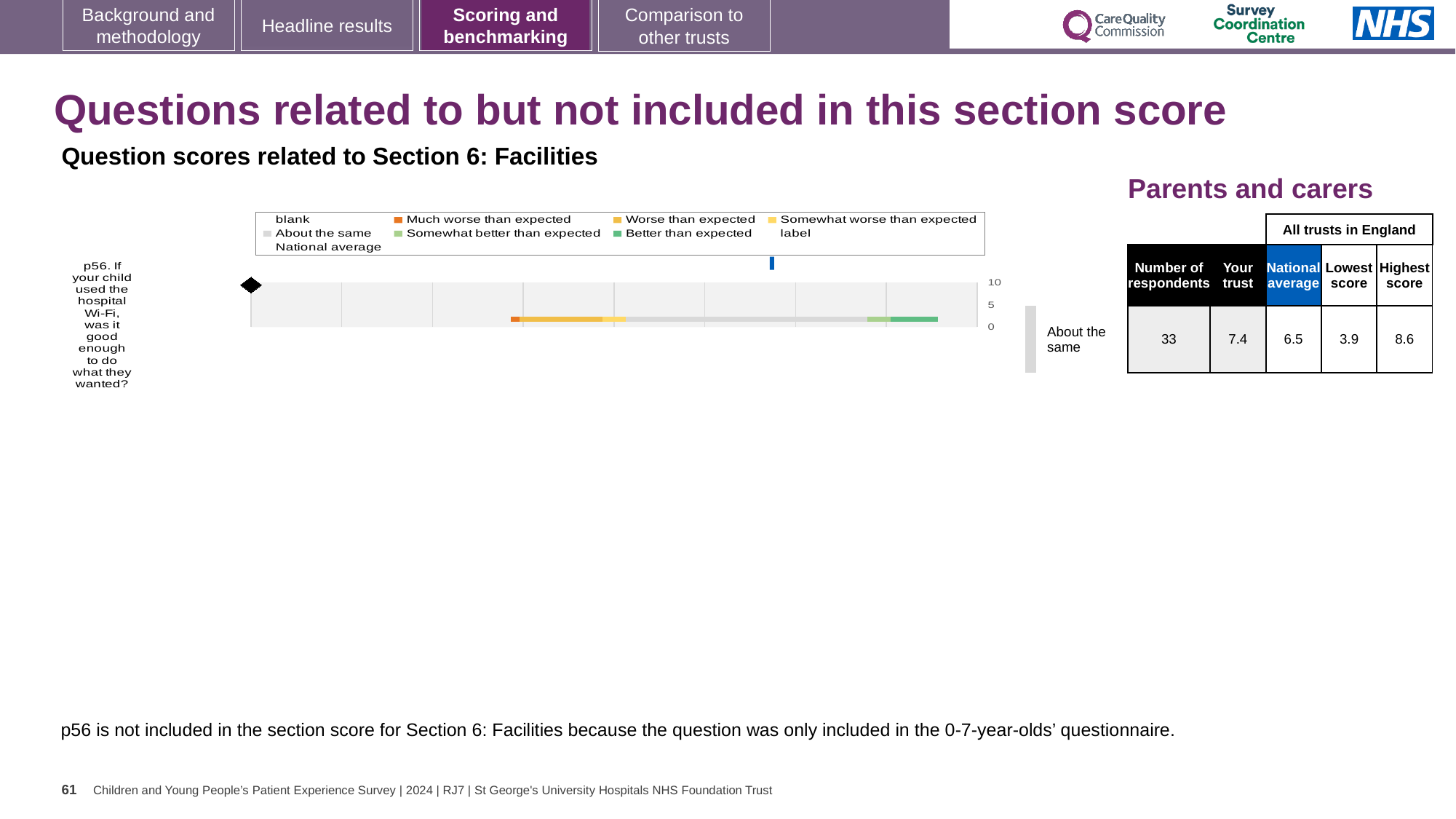
In the table beside the chart, what is the 'Your trust' score for p56? 7.4 Which legend entry is shown in grey? About the same Which legend entry is shown in orange? Much worse than expected In the table beside the chart, what is the national average score for p56? 6.5 Is the national average marker on the chart greater or less than 5? greater In the table beside the chart, how many respondents answered p56? 33 How many questions (categories) are plotted in the chart? 1 What is the highest value shown on the chart's axis? 10 In the table beside the chart, what is the difference between the highest score and the lowest score for p56? 4.7 What benchmark category label is shown to the right of the chart for p56? About the same What kind of chart is shown on the slide? bar chart